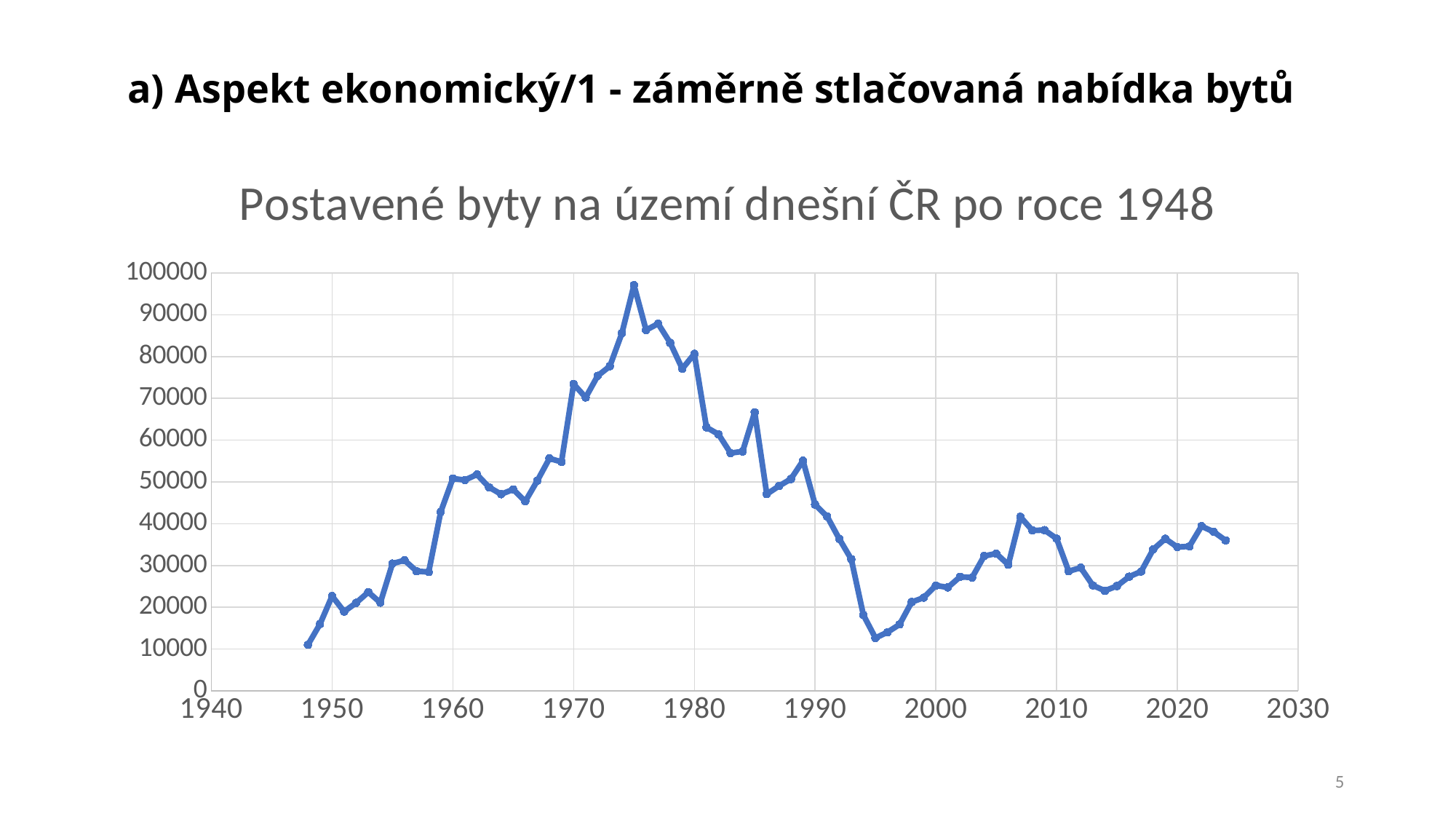
Which year has the larger value, 1975 or 2020? 1975 Is the value for 1960 greater or less than 40000? greater Do the values generally rise or fall between 1975 and 1995? fall In which year does the line reach its highest value? 1975 Is the value for 1975 greater or less than 90000? greater What kind of chart is shown on the slide? line chart Is the value for 1995 greater or less than 20000? less What is the title of the chart? Postavené byty na území dnešní ČR po roce 1948 What is the highest value shown on the vertical axis? 100000